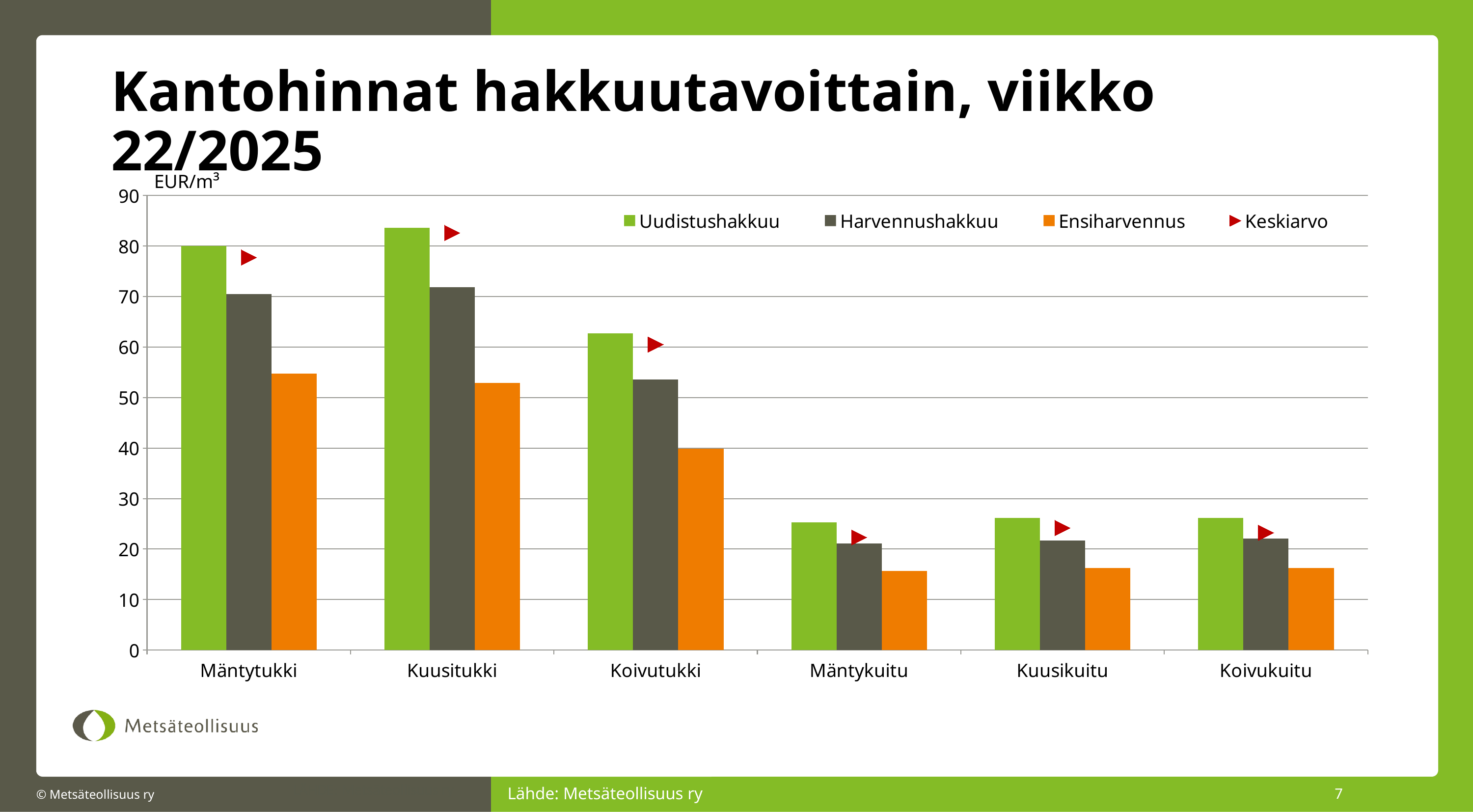
Which is larger, the Uudistushakkuu value for Mäntytukki or for Koivutukki? Mäntytukki What unit is shown on the y axis? EUR/m³ Is the Harvennushakkuu value for Koivutukki greater or less than 50? greater How many series does the legend list? 4 For Koivutukki, which is larger, the Harvennushakkuu value or the Ensiharvennus value? Harvennushakkuu Is the Uudistushakkuu value for Kuusitukki greater or less than 80? greater What kind of chart is shown on the slide? bar chart Is the Ensiharvennus value for Mäntytukki greater or less than 50? greater How many categories are shown on the x axis? 6 Which category has the highest Uudistushakkuu value? Kuusitukki